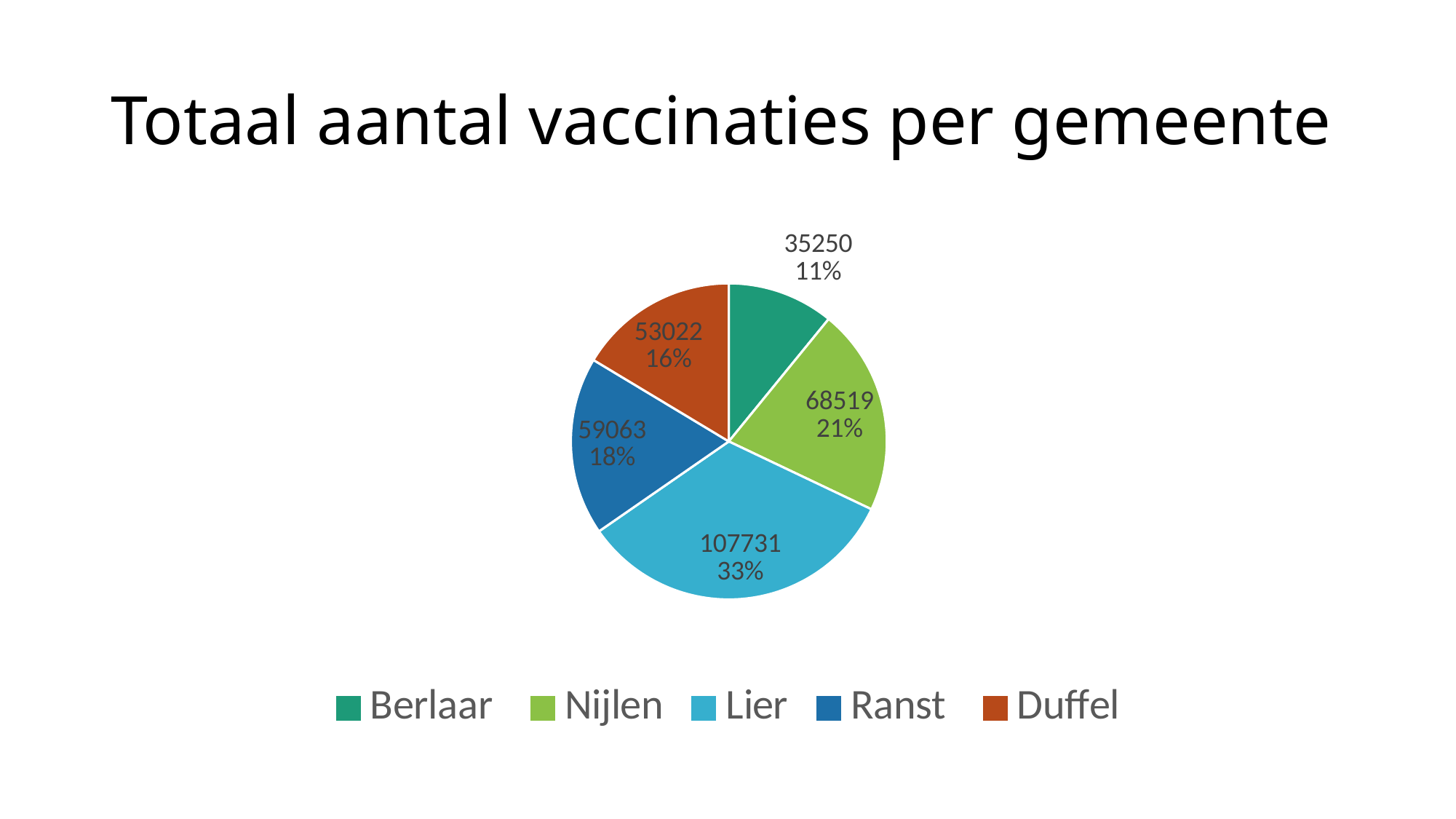
What is the total number of vaccinations for Berlaar? 35250 What is the title of the chart? Totaal aantal vaccinaties per gemeente Which municipality has the lowest number of vaccinations? Berlaar Which municipality has the highest number of vaccinations? Lier What is the total number of vaccinations for Lier? 107731 What share of the pie does Nijlen represent? 21% What is the total number of vaccinations for Ranst? 59063 What is the difference in vaccinations between Lier and Nijlen? 39212 What share of the pie does Duffel represent? 16% What type of chart is shown on the slide? pie chart Which has more vaccinations, Ranst or Duffel? Ranst How many municipalities are shown in the pie chart? 5